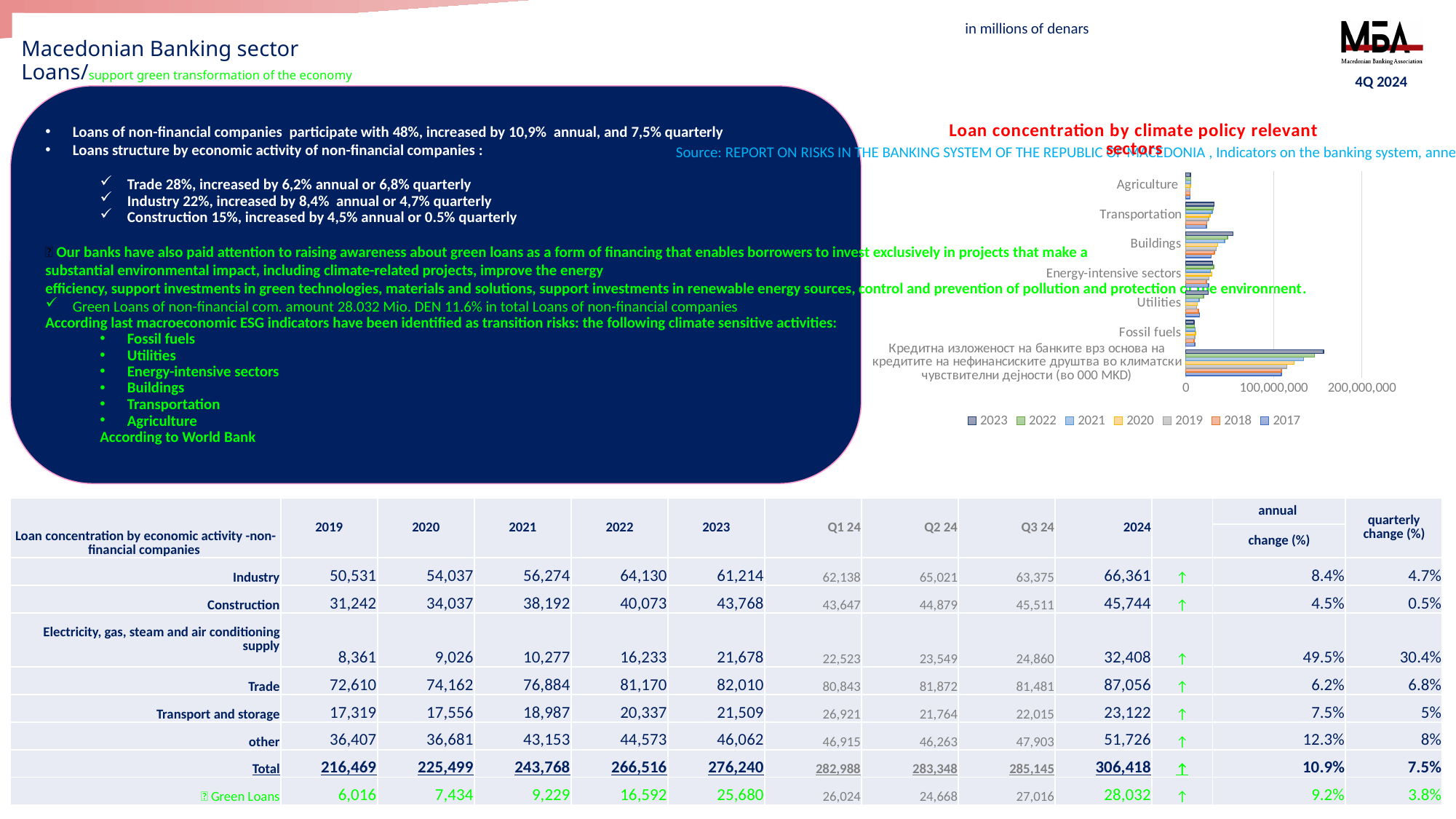
What kind of chart is shown under the title "Loan concentration by climate policy relevant sectors"? bar chart In the "Loan concentration by climate policy relevant sectors" chart, is the 2023 value for the total category (the long Cyrillic label at the bottom) greater or less than 100,000,000? greater In the "Loan concentration by climate policy relevant sectors" chart, which is larger for 2023: Buildings or Fossil fuels? Buildings How many categories are shown on the vertical axis of the "Loan concentration by climate policy relevant sectors" chart? 7 How many series does the legend of the "Loan concentration by climate policy relevant sectors" chart list? 7 In the "Loan concentration by climate policy relevant sectors" chart, which of the named sectors (Agriculture, Transportation, Buildings, Energy-intensive sectors, Utilities, Fossil fuels) has the longest 2023 bar? Buildings In the "Loan concentration by climate policy relevant sectors" chart, which is larger for 2023: Transportation or Agriculture? Transportation In the "Loan concentration by climate policy relevant sectors" chart, is the 2023 value for Agriculture greater or less than 100,000,000? less Which years are listed in the legend of the "Loan concentration by climate policy relevant sectors" chart? 2023, 2022, 2021, 2020, 2019, 2018, 2017 What is the highest tick value shown on the horizontal axis of the "Loan concentration by climate policy relevant sectors" chart? 200,000,000 In the "Loan concentration by climate policy relevant sectors" chart, is the 2023 value for Buildings greater or less than 100,000,000? less In the "Loan concentration by climate policy relevant sectors" chart, which of the named sectors (Agriculture, Transportation, Buildings, Energy-intensive sectors, Utilities, Fossil fuels) has the smallest bars? Agriculture